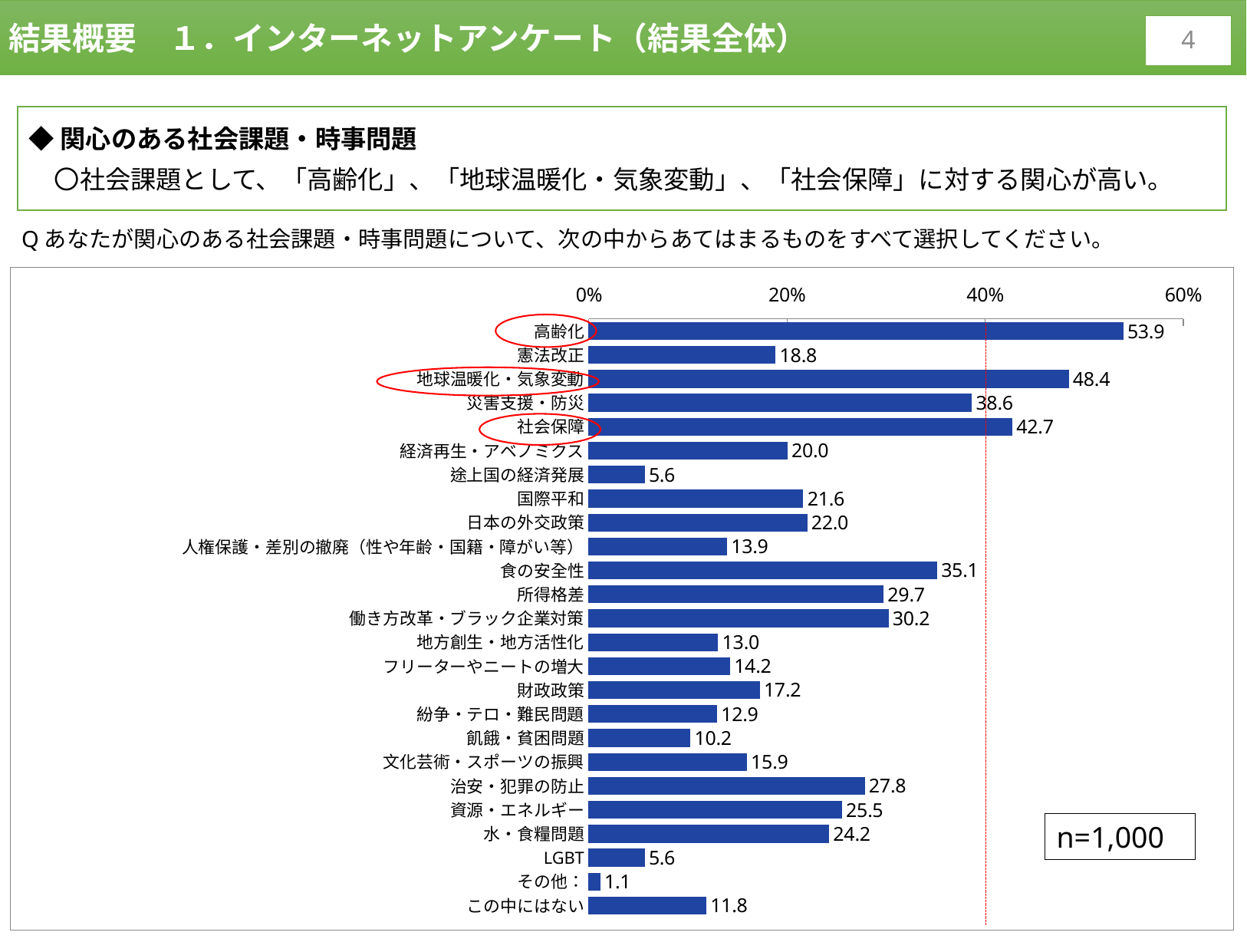
What is the sample size shown on the chart? n=1,000 Is the value for 災害支援・防災 greater or less than 40%? less What kind of chart is shown on the slide? bar chart What is the value for LGBT? 5.6 What is the value for 高齢化? 53.9 Which category has the highest value? 高齢化 What is the difference between the values for 高齢化 and 地球温暖化・気象変動? 5.5 Which category has the lowest value? その他： What is the value for 社会保障? 42.7 What is the value for 食の安全性? 35.1 How many categories are shown in the chart? 25 Which is larger, the value for 所得格差 or the value for 働き方改革・ブラック企業対策? 働き方改革・ブラック企業対策